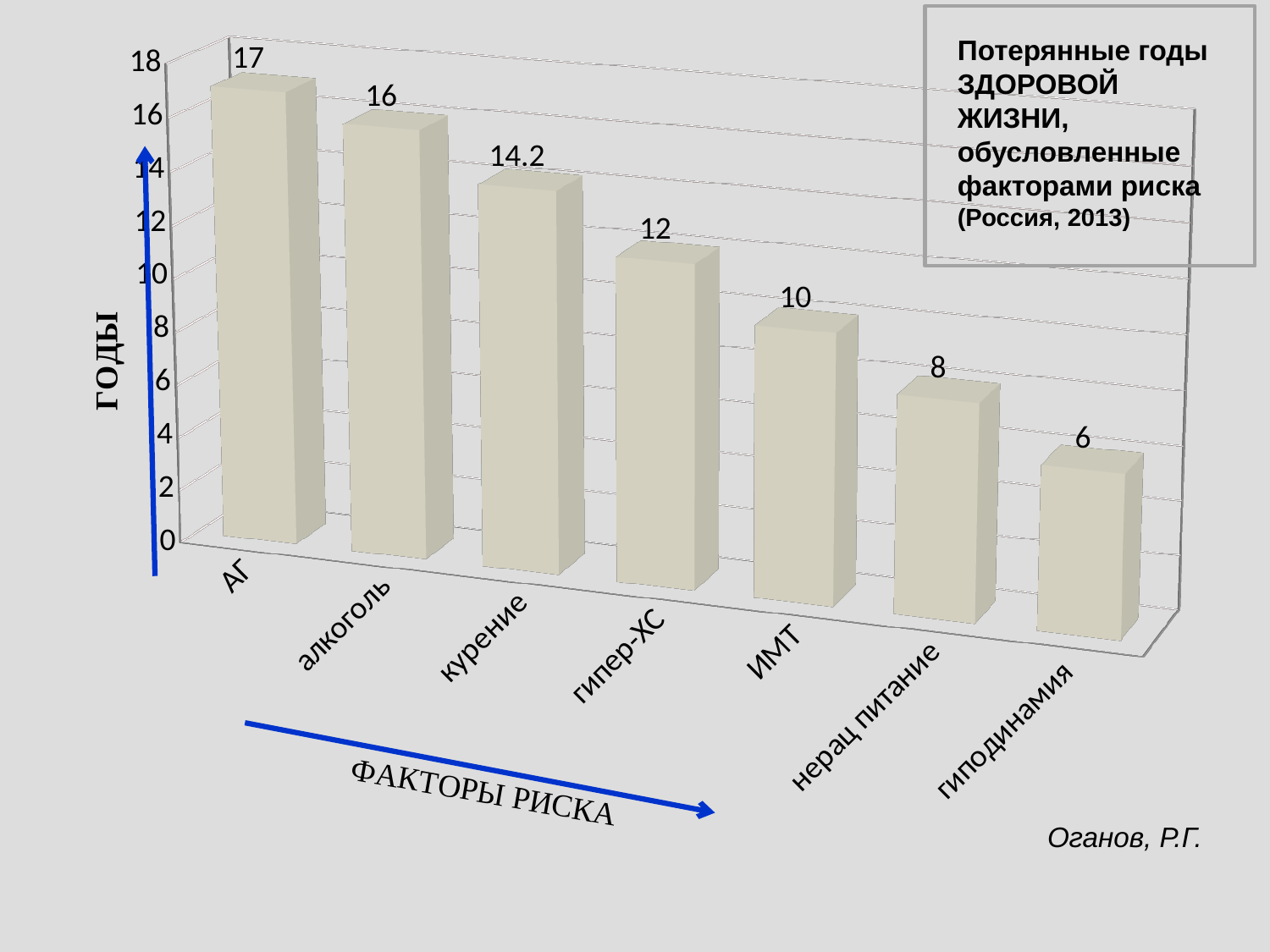
What is the value for АГ? 17 What is the value for курение? 14.2 Which category has the highest value? АГ What is the difference between the values for алкоголь and гипер-ХС? 4 What is the value for гиподинамия? 6 How many categories are shown on the x axis? 7 What is the label of the vertical axis? ГОДЫ Which category has the lowest value? гиподинамия What is the value for ИМТ? 10 What kind of chart is this? bar chart Do the values rise or fall from left to right along the x axis? fall Which is larger, the value for нерац питание or the value for ИМТ? ИМТ